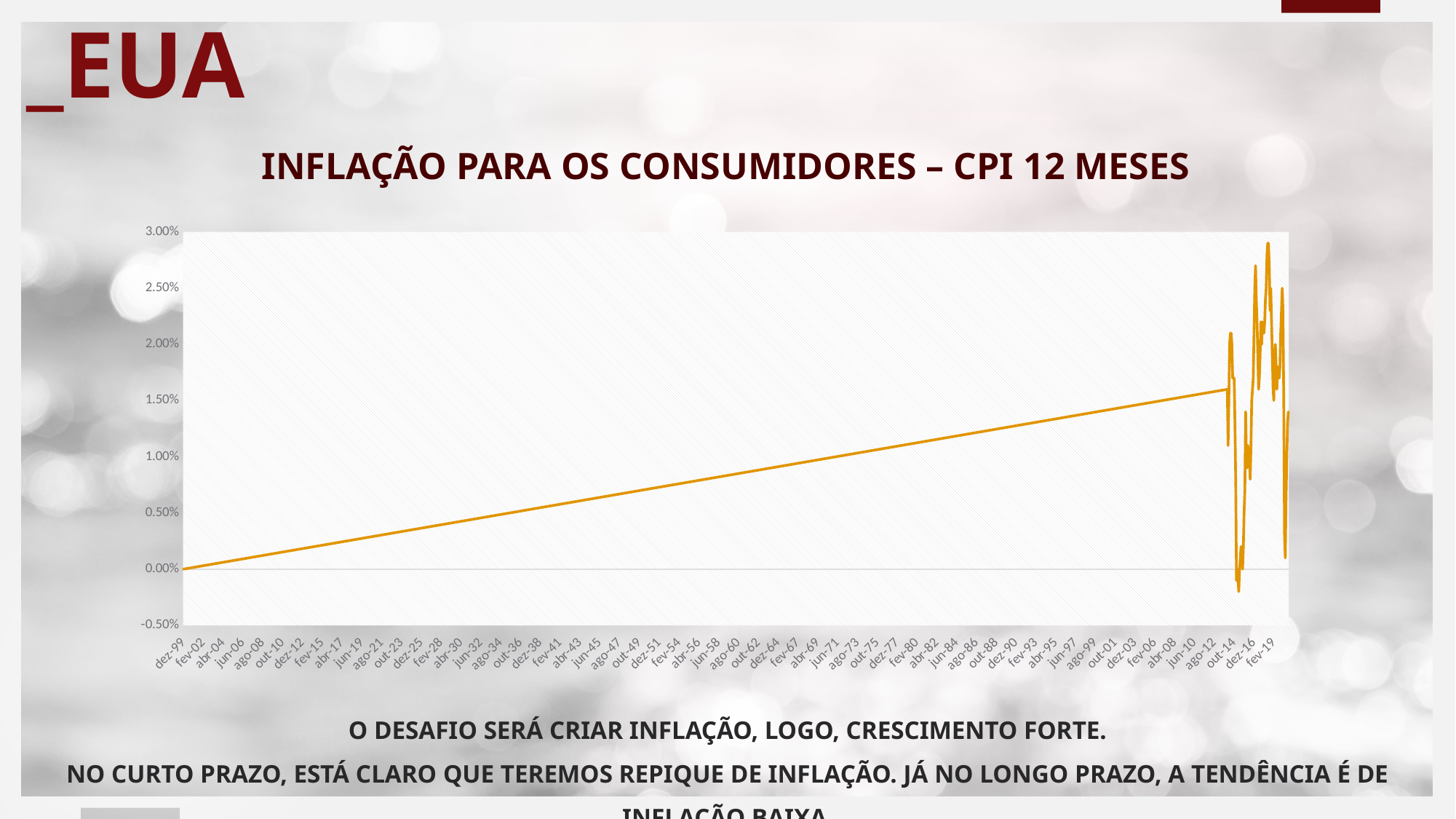
What is the first category label on the horizontal axis? dez-99 What is the highest value shown on the vertical axis of the chart? 3.00% Is the peak value of the line greater or less than 2.50%? greater Is the lowest value of the line greater or less than 0.00%? less Does the line rise or fall between dez-99 and ago-12? rise What is the title of the chart? INFLAÇÃO PARA OS CONSUMIDORES – CPI 12 MESES Is the value of the line at ago-12 greater or less than 2.00%? less Which is larger, the value at dez-99 or the value at ago-12? ago-12 What kind of chart is shown on the slide? line chart How many data series are plotted in the chart? 1